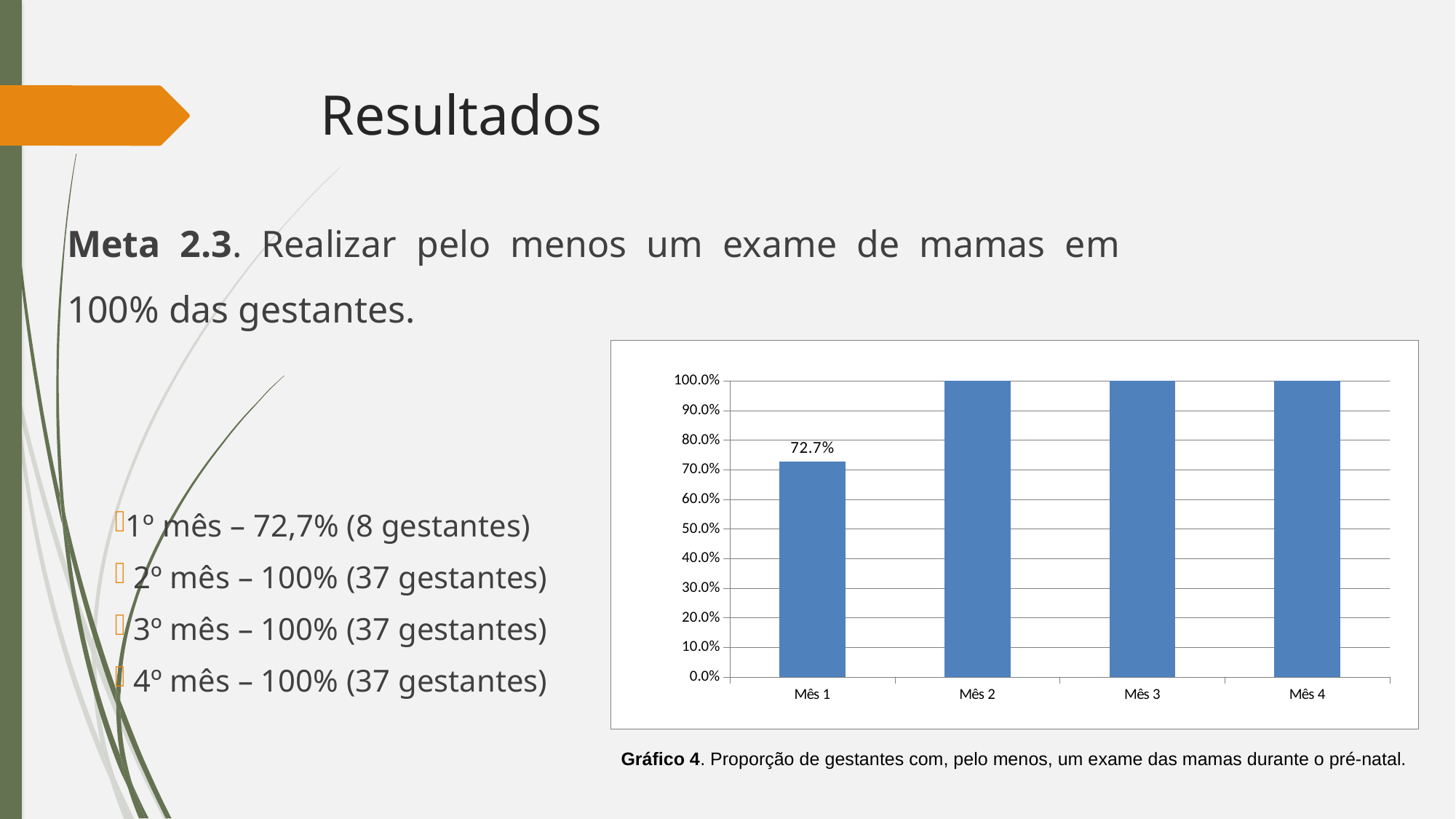
What kind of chart is shown on the slide? bar chart How many categories are plotted on the x axis of the chart? 4 What is the value shown for Mês 1? 72.7% What is the difference between the value for Mês 2 and the value for Mês 1? 27.3% Is the value for Mês 1 greater or less than 80.0%? less Do the values rise or fall from Mês 1 to Mês 2? rise What is the caption number given for the chart below it? Gráfico 4 Which is larger, the value for Mês 1 or the value for Mês 3? Mês 3 What value does the bar for Mês 2 reach on the y axis? 100.0% What value does the bar for Mês 4 reach on the y axis? 100.0% What colour are the bars in the chart? blue Which category has the lowest value in the chart? Mês 1